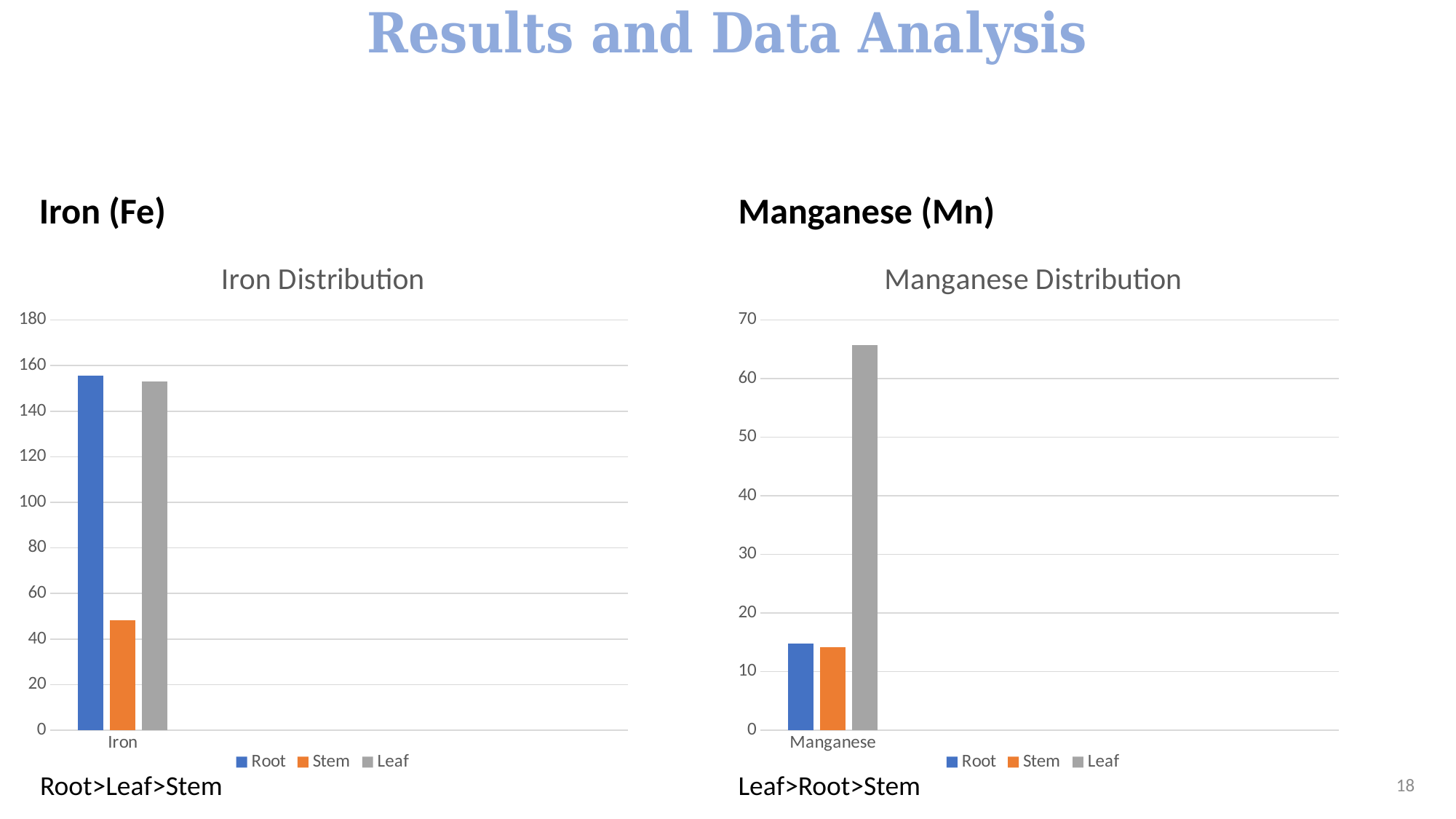
In the Iron Distribution chart, which is larger, the value for Root or the value for Stem? Root In the Manganese Distribution chart, which series has the highest value? Leaf In the Iron Distribution chart, is the value for Stem greater or less than 60? less In the Manganese Distribution chart, is the value for Leaf greater or less than 60? greater What kind of chart is the Iron Distribution chart? bar chart In the Manganese Distribution chart, is the value for Stem greater or less than 20? less How many series does the legend of the Manganese Distribution chart list? 3 What is the title of the chart on the right side of the slide? Manganese Distribution In the Iron Distribution chart, which series has the lowest value? Stem In the Iron Distribution chart, what colour is the Leaf series? grey In the Manganese Distribution chart, which is larger, the value for Leaf or the value for Root? Leaf